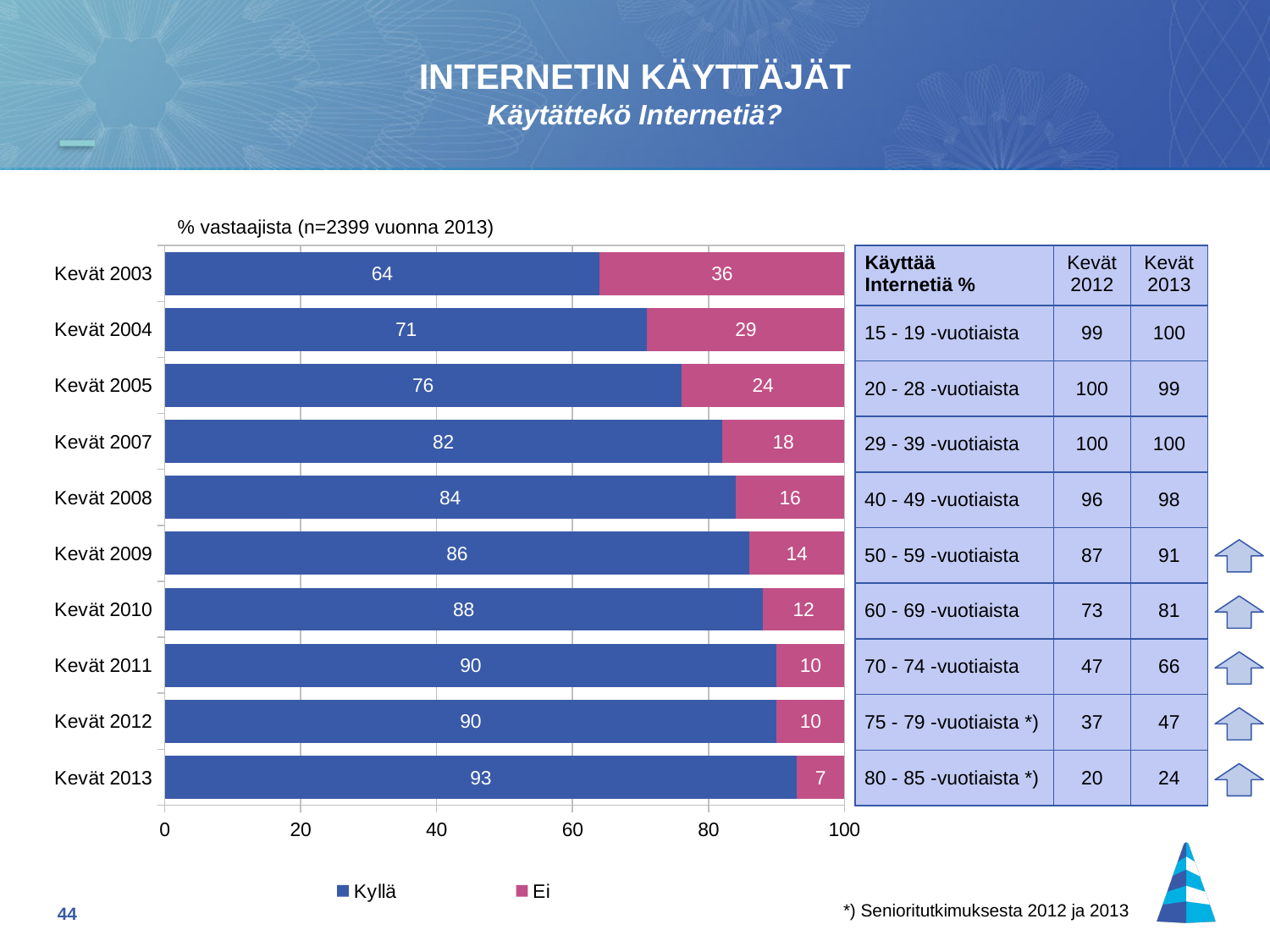
What is the Kyllä value for Kevät 2008? 84 Which year has the lowest Kyllä value? Kevät 2003 What is the difference between the Kyllä values for Kevät 2013 and Kevät 2003? 29 How many series does the legend list? 2 What is the total of the stacked bar for Kevät 2010? 100 What kind of chart is shown on the slide? Stacked bar chart What is the Kyllä value for Kevät 2003? 64 What is the Ei value for Kevät 2013? 7 How many years (categories) are shown in the bar chart? 10 Which year has the highest Kyllä value? Kevät 2013 Which is larger, the Ei value for Kevät 2005 or the Ei value for Kevät 2009? Kevät 2005 Does the Kyllä value rise or fall from Kevät 2003 to Kevät 2013? Rise